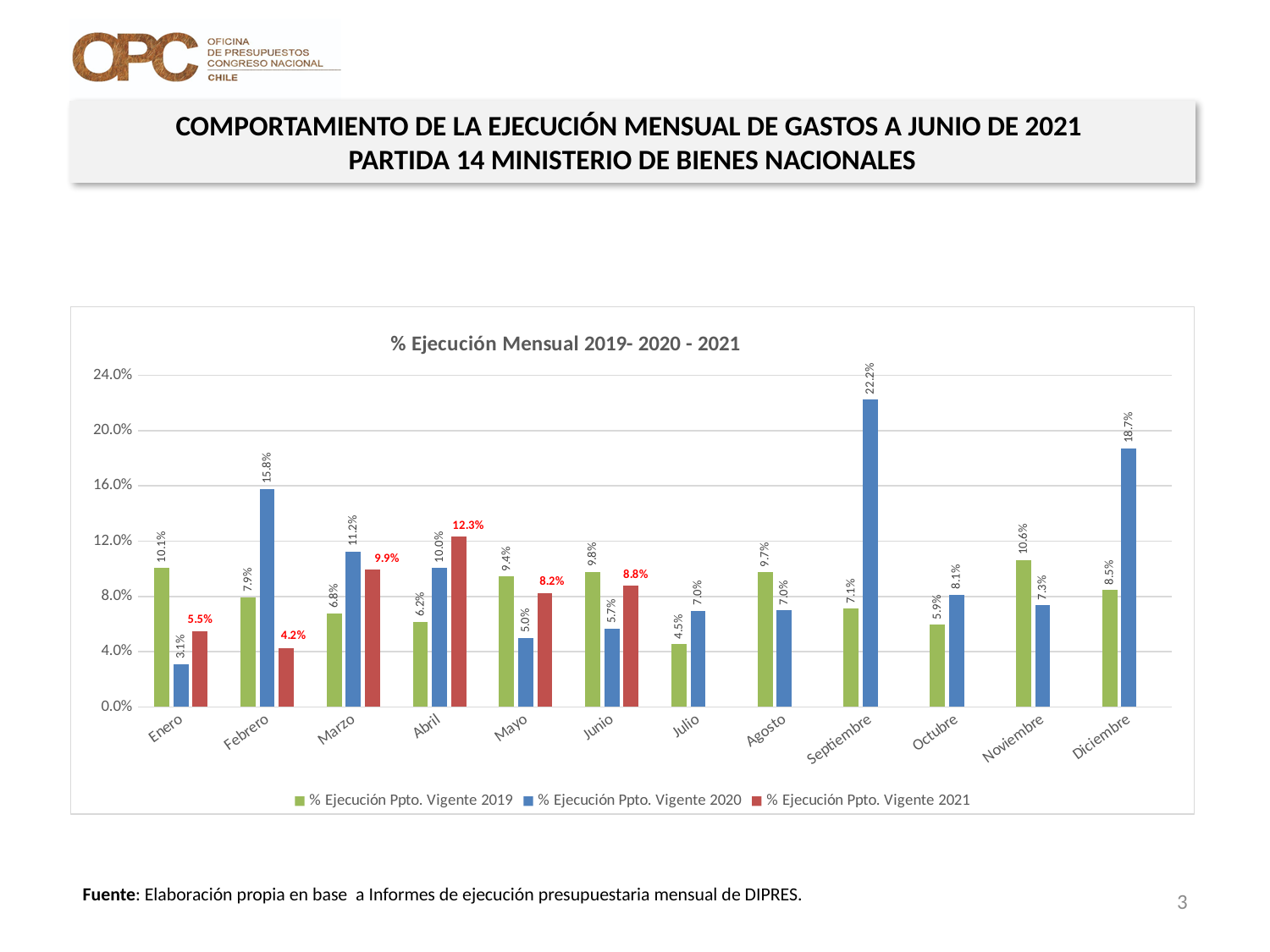
Which month has the lowest value for % Ejecución Ppto. Vigente 2021? Febrero Is the value for % Ejecución Ppto. Vigente 2020 in Diciembre greater or less than 16.0%? greater What is the value for % Ejecución Ppto. Vigente 2020 in Septiembre? 22.2% What kind of chart is shown? Bar chart Which is larger in Junio: the 2019 value or the 2021 value? 2019 value (9.8%) What is the title of the chart? % Ejecución Mensual 2019- 2020 - 2021 How many months are shown on the x axis? 12 Which month has the highest value for % Ejecución Ppto. Vigente 2020? Septiembre What is the value for % Ejecución Ppto. Vigente 2021 in Abril? 12.3% How many series does the legend list? 3 What is the difference between the 2020 and 2019 values in Febrero? 7.9% What is the value for % Ejecución Ppto. Vigente 2019 in Noviembre? 10.6%